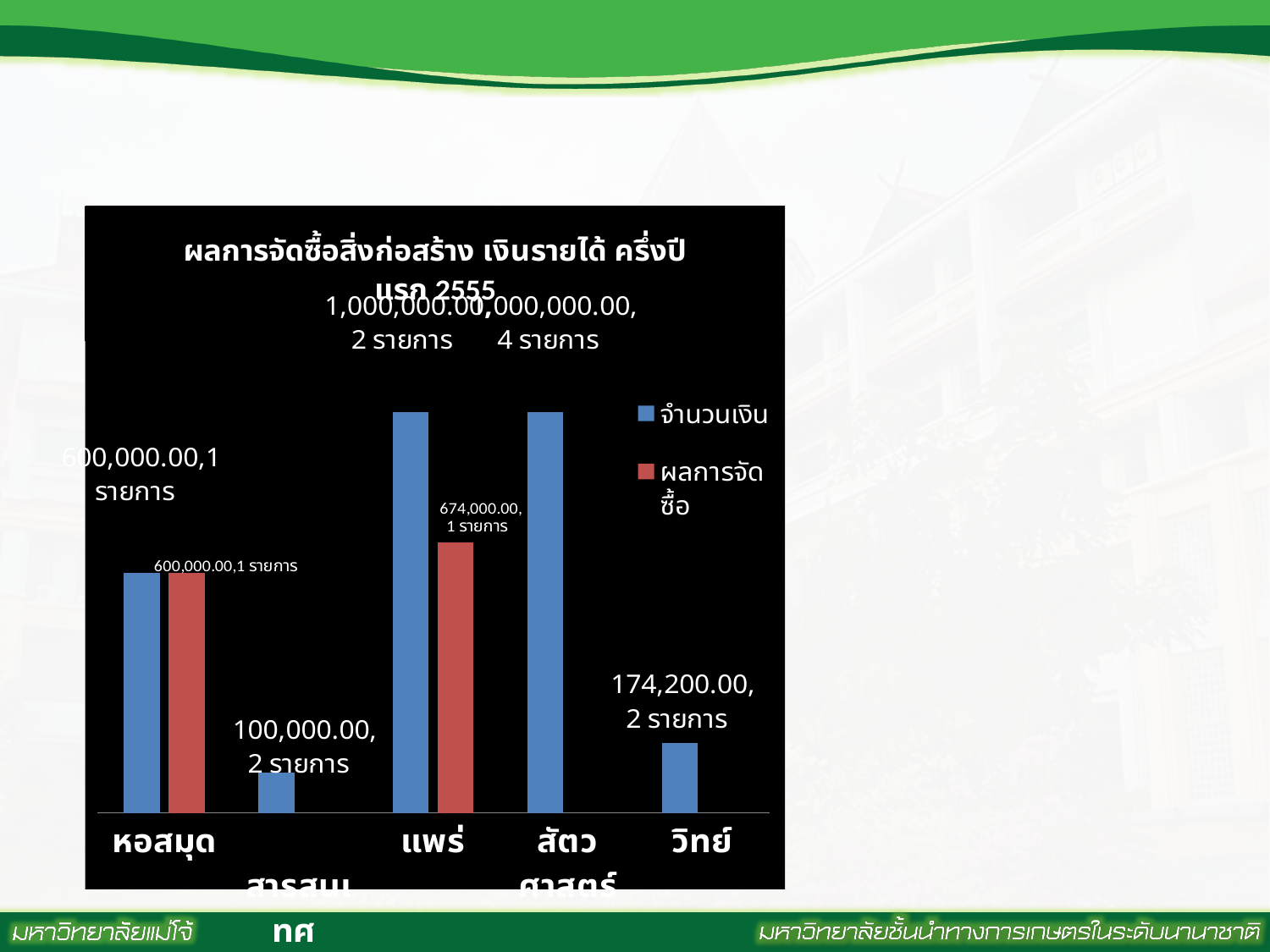
What is the จำนวนเงิน value for วิทย์? 174,200.00 What is the difference between the จำนวนเงิน and ผลการจัดซื้อ values for แพร่? 326,000.00 How many รายการ are shown in the จำนวนเงิน label for สัตวศาสตร์? 4 รายการ How many categories are shown on the x axis of the chart? 5 How many categories have a ผลการจัดซื้อ (red) bar? 2 What is the จำนวนเงิน value for หอสมุด? 600,000.00 What is the ผลการจัดซื้อ value for แพร่? 674,000.00 What kind of chart is shown on the slide? bar chart What are the two series named in the legend? จำนวนเงิน and ผลการจัดซื้อ How many รายการ are shown in the จำนวนเงิน label for วิทย์? 2 รายการ How many series does the chart legend list? 2 Which has the larger จำนวนเงิน value, หอสมุด or วิทย์? หอสมุด